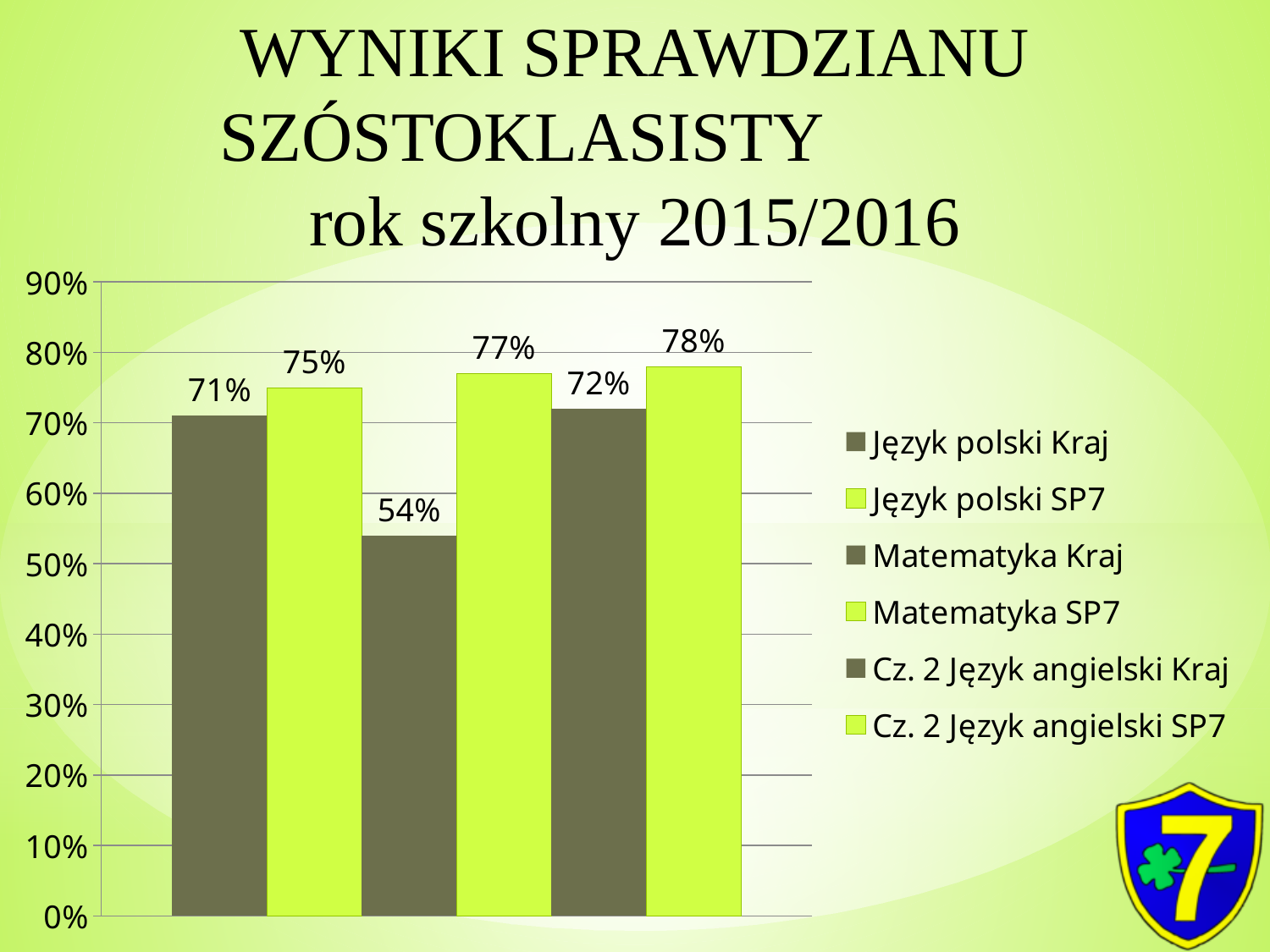
Which series has the lowest value? Matematyka Kraj What is the difference between Matematyka SP7 and Matematyka Kraj? 23% What is the value for Matematyka SP7? 77% What is the value for Język polski Kraj? 71% Which is larger, Cz. 2 Język angielski SP7 or Cz. 2 Język angielski Kraj? Cz. 2 Język angielski SP7 What is the value for Cz. 2 Język angielski Kraj? 72% What is the difference between Język polski SP7 and Język polski Kraj? 4% What kind of chart is shown on the slide? bar chart What colour are the SP7 bars in the chart? light green How many series does the legend list? 6 Is the value for Matematyka Kraj greater or less than 60%? less Which series has the highest value? Cz. 2 Język angielski SP7